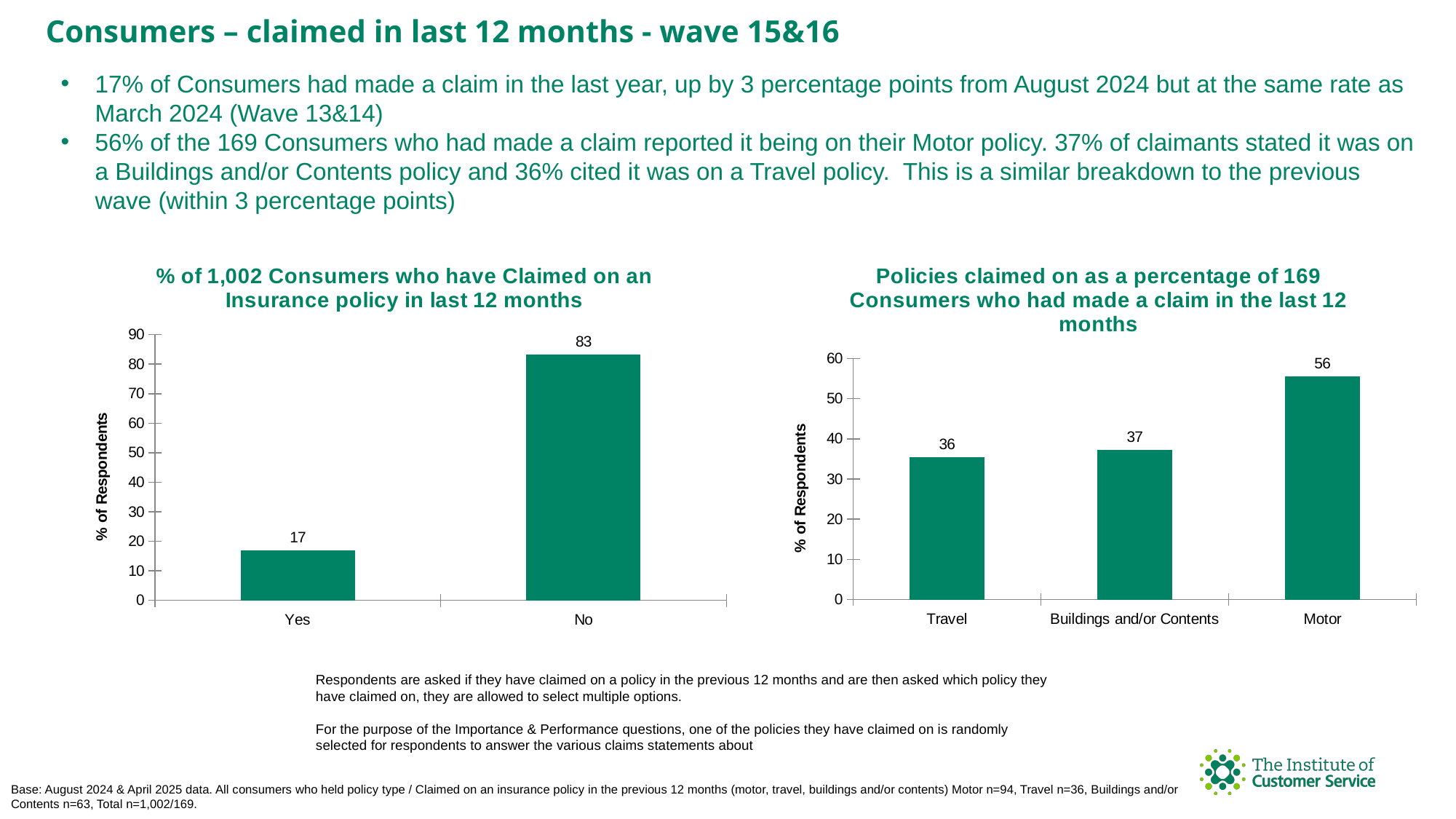
What kind of chart is the right chart (Policies claimed on as a percentage of 169 Consumers)? Bar chart What is the y-axis label of the left chart (% of 1,002 Consumers who have Claimed on an Insurance policy in last 12 months)? % of Respondents In the left chart (% of 1,002 Consumers who have Claimed on an Insurance policy in last 12 months), what is the value for Yes? 17 In the right chart (Policies claimed on as a percentage of 169 Consumers), which category has the highest value? Motor In the right chart (Policies claimed on as a percentage of 169 Consumers), how many categories are shown on the x axis? 3 In the left chart (% of 1,002 Consumers who have Claimed on an Insurance policy in last 12 months), how many categories are shown on the x axis? 2 In the left chart (% of 1,002 Consumers who have Claimed on an Insurance policy in last 12 months), what is the value for No? 83 In the right chart (Policies claimed on as a percentage of 169 Consumers), what is the value for Travel? 36 In the right chart (Policies claimed on as a percentage of 169 Consumers), what is the value for Buildings and/or Contents? 37 In the right chart (Policies claimed on as a percentage of 169 Consumers), what is the value for Motor? 56 In the left chart (% of 1,002 Consumers who have Claimed on an Insurance policy in last 12 months), what is the difference between the No and Yes values? 66 In the right chart (Policies claimed on as a percentage of 169 Consumers), what is the difference between the Motor and Travel values? 20